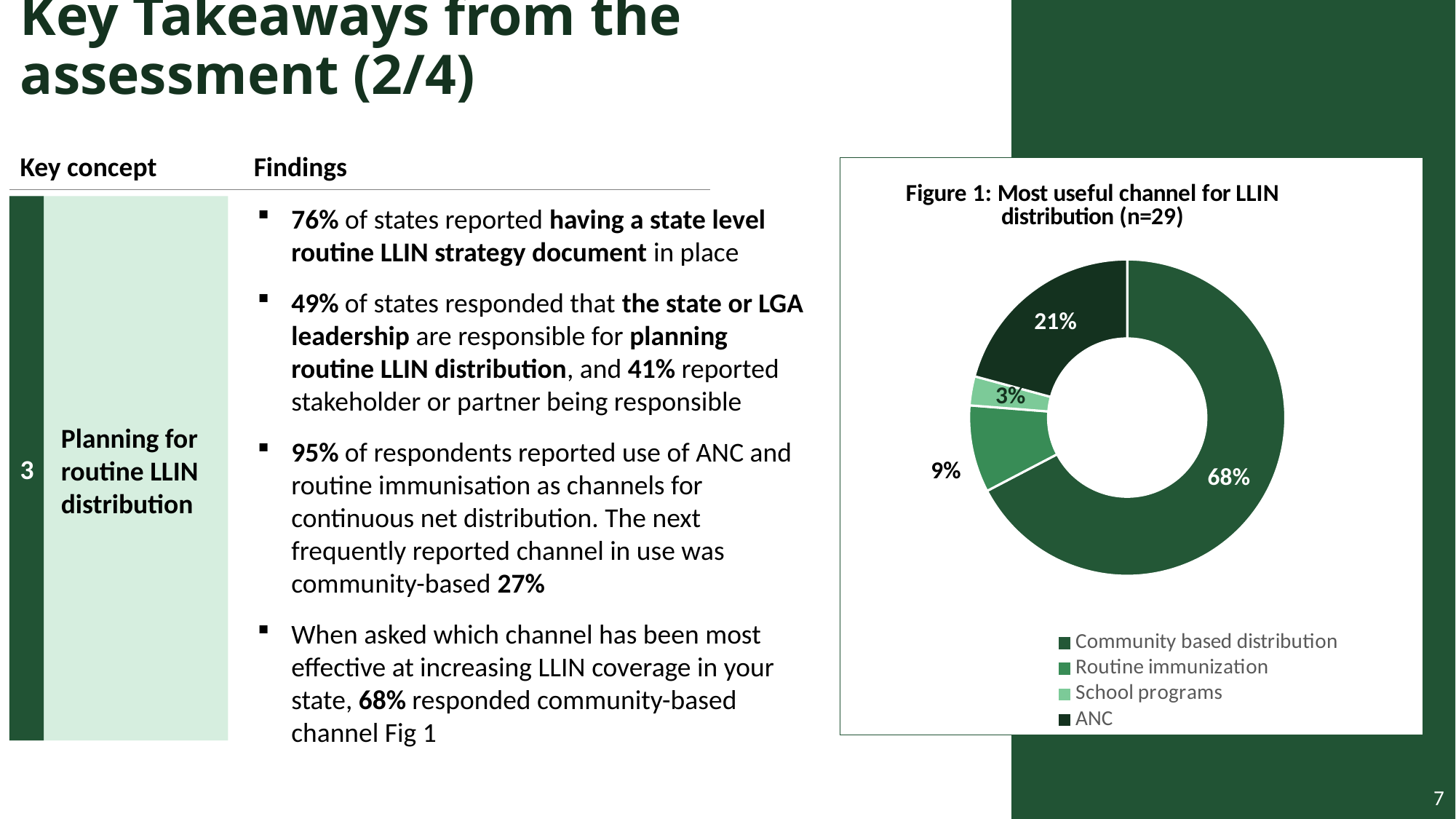
What is the difference between the shares for Community based distribution and ANC? 47% Which is larger, the share for ANC or the share for Routine immunization? ANC Which channel has the largest share in the chart? Community based distribution What share of the pie does Community based distribution account for? 68% How many categories are shown in the chart? 4 What is the value for School programs? 3% What is the sample size (n) stated in the chart title? 29 Which channel has the smallest share in the chart? School programs What kind of chart is shown on the slide? Pie chart (doughnut) What is the value for Routine immunization? 9% What is the title of the chart? Figure 1: Most useful channel for LLIN distribution (n=29) What is the value for ANC in the chart? 21%